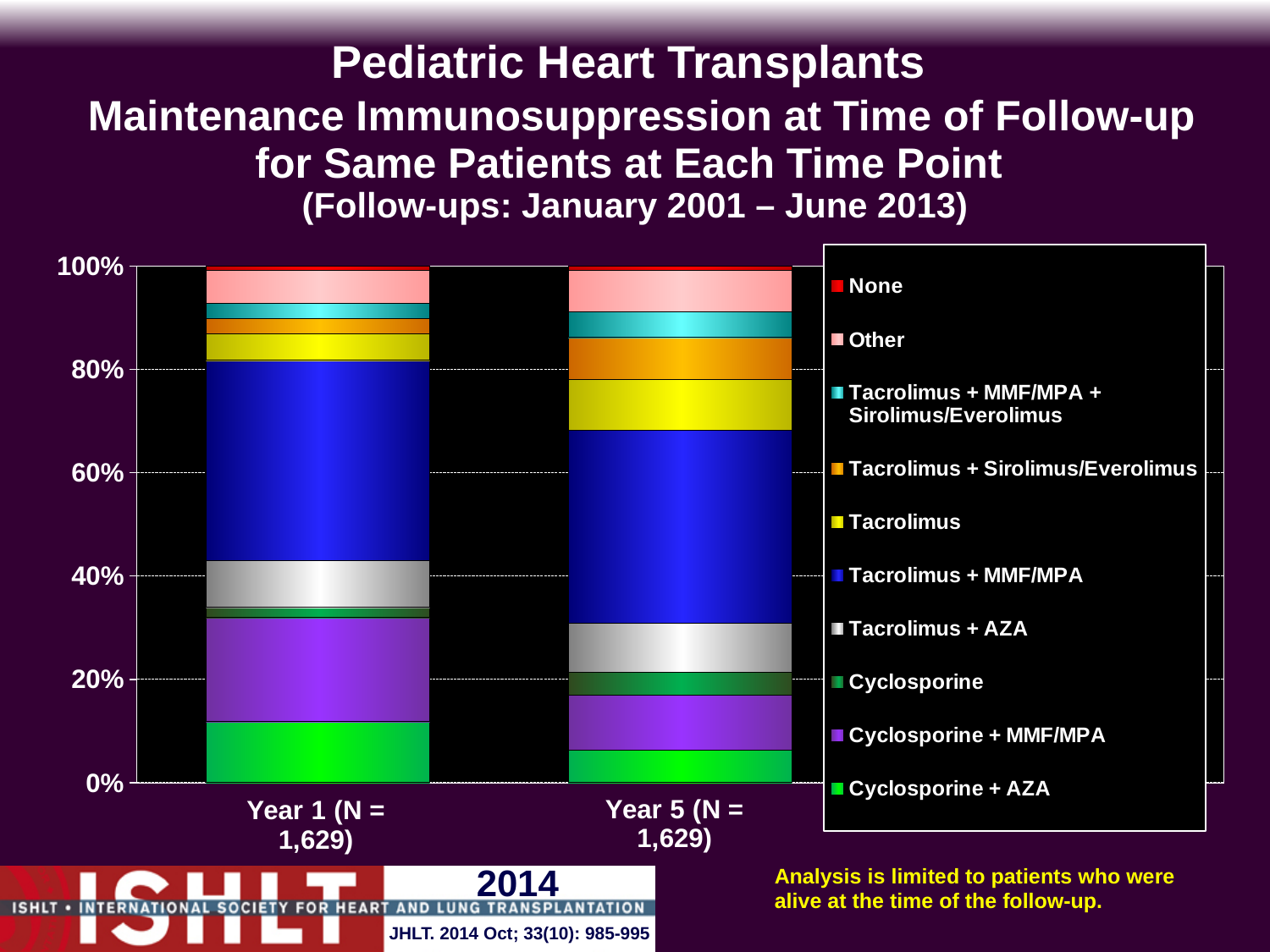
How many immunosuppression regimens does the legend list? 10 What do the segments of each stacked bar sum to? 100% Is the Cyclosporine + AZA share at Year 1 greater or less than 20%? less Is the Cyclosporine + AZA share larger at Year 1 or at Year 5? Year 1 Is the Tacrolimus (alone) share larger at Year 1 or at Year 5? Year 5 How many time-point categories are plotted on the x axis? 2 Which regimen makes up the largest segment of the Year 5 bar? Tacrolimus + MMF/MPA What kind of chart is shown on the slide? Stacked bar chart What is the N shown for the Year 5 category? 1,629 Does the Cyclosporine + MMF/MPA share rise or fall from Year 1 to Year 5? fall Which regimen makes up the largest segment of the Year 1 bar? Tacrolimus + MMF/MPA Which legend entry is shown in red? None